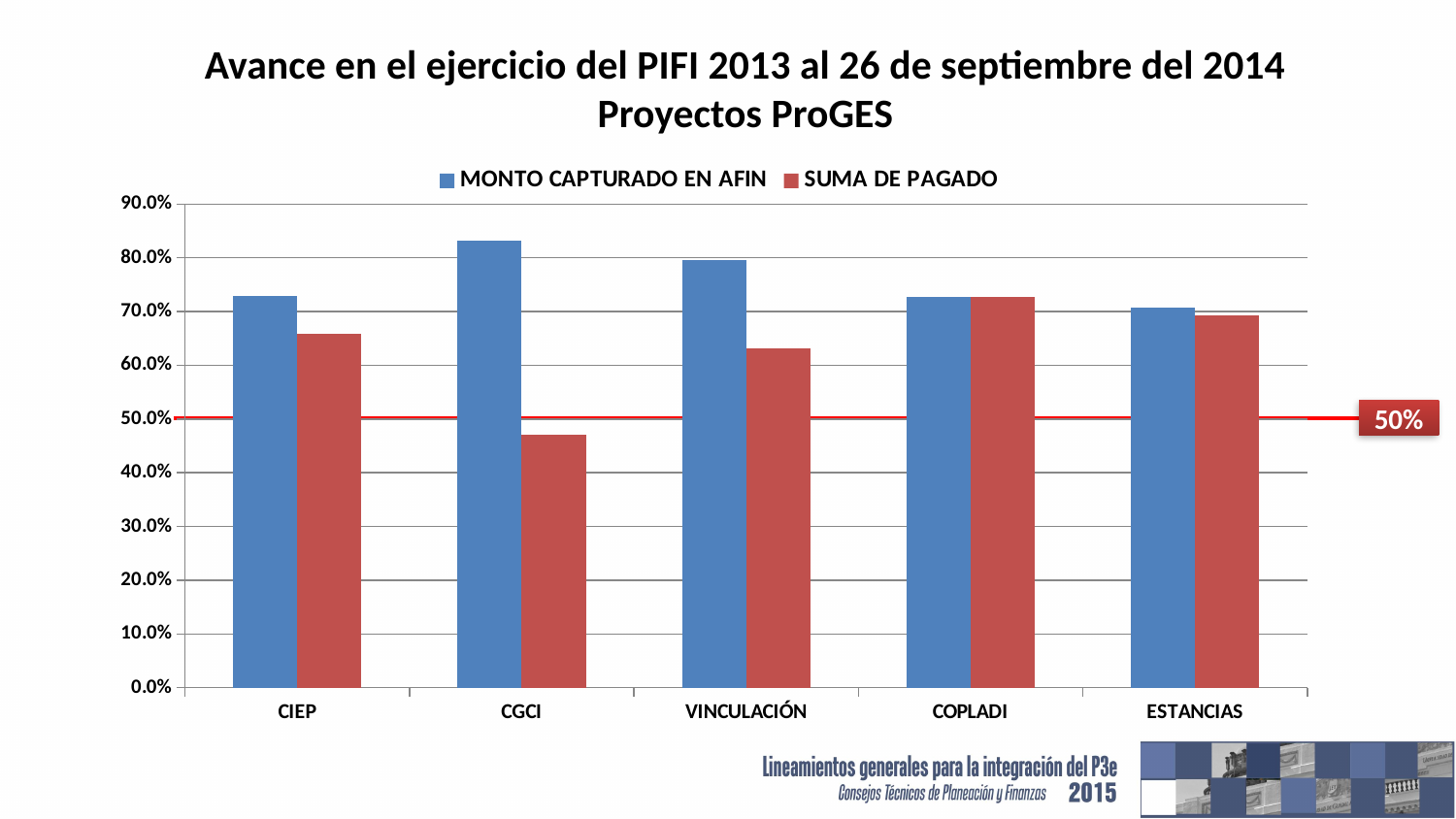
Is the SUMA DE PAGADO value for CGCI greater or less than 50%? less Which category has the lowest value for SUMA DE PAGADO? CGCI Is the MONTO CAPTURADO EN AFIN value for CGCI greater or less than 80%? greater Is the MONTO CAPTURADO EN AFIN value for CIEP greater or less than 70%? greater How many series does the chart's legend list? 2 What percentage does the red horizontal reference line on the chart mark? 50% For VINCULACIÓN, which is larger: MONTO CAPTURADO EN AFIN or SUMA DE PAGADO? MONTO CAPTURADO EN AFIN Which series is shown in blue in the chart's legend? MONTO CAPTURADO EN AFIN How many categories are shown on the x axis of the chart? 5 What kind of chart is shown on the slide? Bar chart Which category has the highest value for MONTO CAPTURADO EN AFIN? CGCI